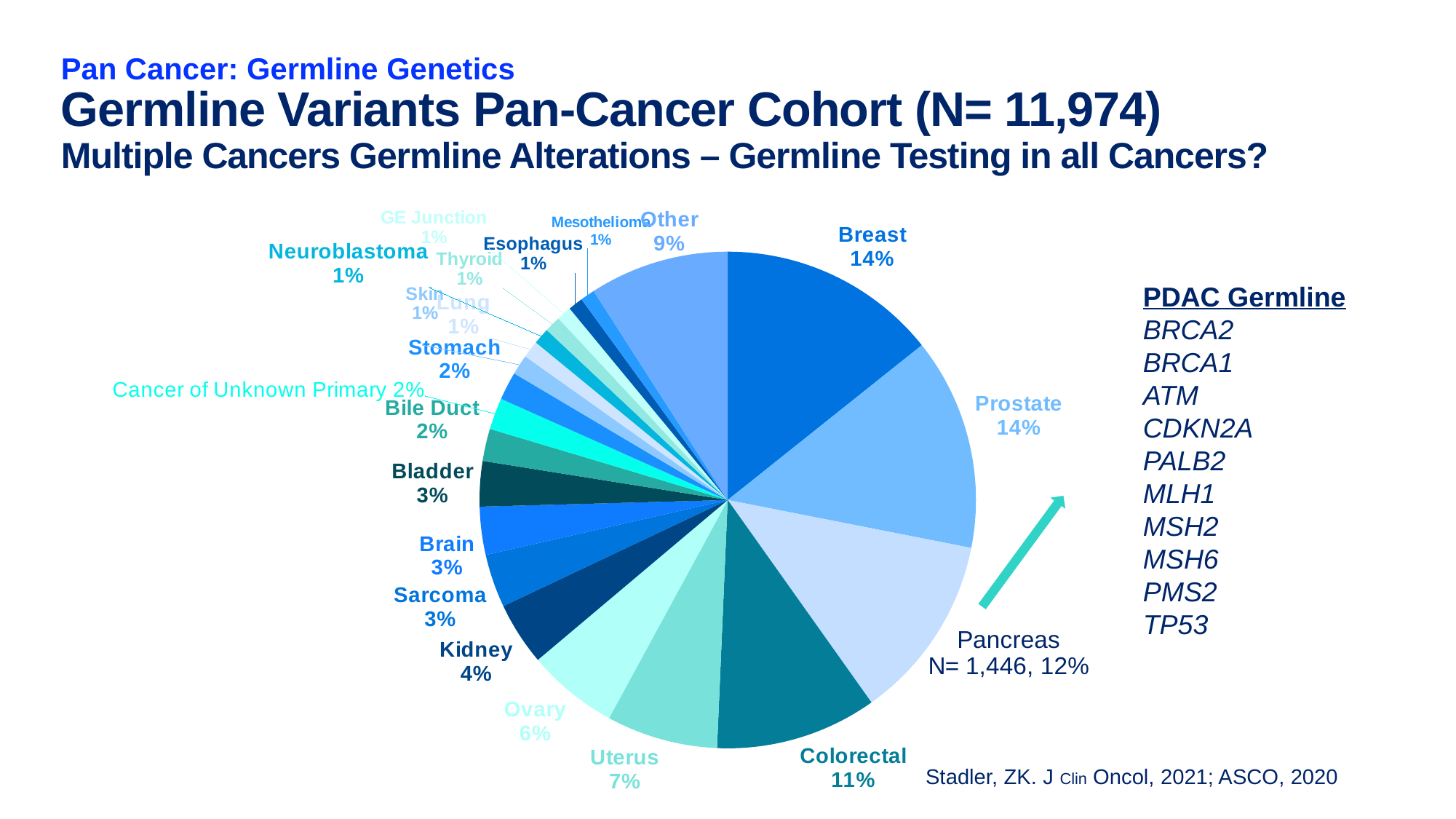
What percentage of the pie chart is Pancreas? 12% What percentage of the pie chart is Breast? 14% Which slice is larger in the pie chart, Ovary or Uterus? Uterus What percentage of the pie chart is Kidney? 4% What percentage of the pie chart is Uterus? 7% What percentage of the pie chart is Colorectal? 11% What is the difference in percentage points between Breast and Colorectal in the pie chart? 3 What is the total cohort size (N) given in the slide title? 11,974 What percentage of the pie chart is labelled Other? 9% Which slice is larger in the pie chart, Kidney or Bladder? Kidney What type of chart is shown on the slide? pie chart What is the N value shown for Pancreas in the pie chart? N= 1,446